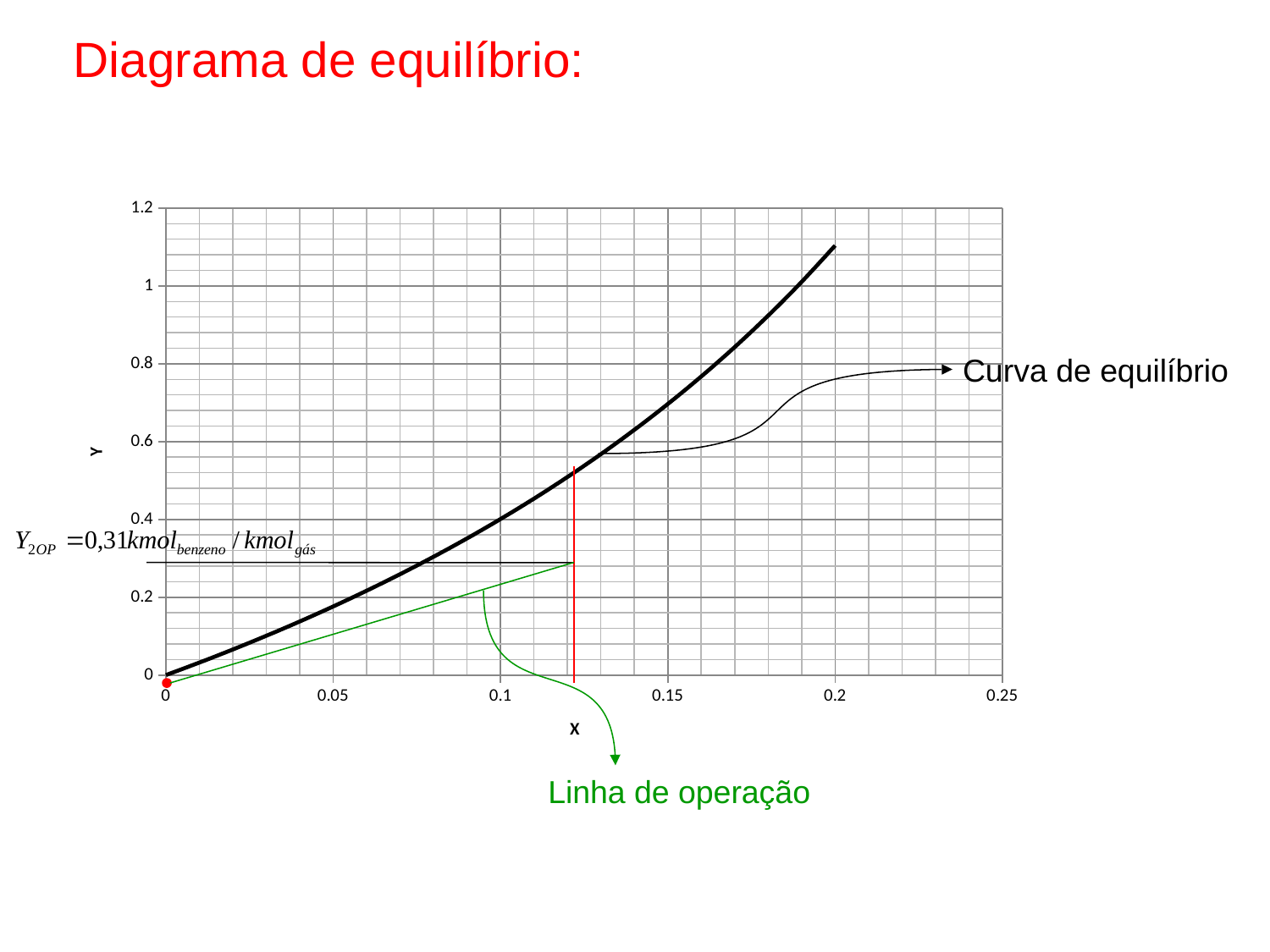
What kind of chart is shown on the slide? line chart What label is given to the green line on the chart? Linha de operação Is the value of the equilibrium curve at X = 0.15 greater or less than 0.6? greater What is the title of the slide containing the chart? Diagrama de equilíbrio: Does the equilibrium curve (Curva de equilíbrio) rise or fall as X increases? rise At X = 0.1, which is higher: the equilibrium curve or the operating line (Linha de operação)? the equilibrium curve Is the value of the equilibrium curve at X = 0.2 greater or less than 1? greater What value of Y_2OP is printed on the slide? 0,31 kmol benzeno / kmol gás Is the value of the equilibrium curve at X = 0.05 greater or less than 0.4? less